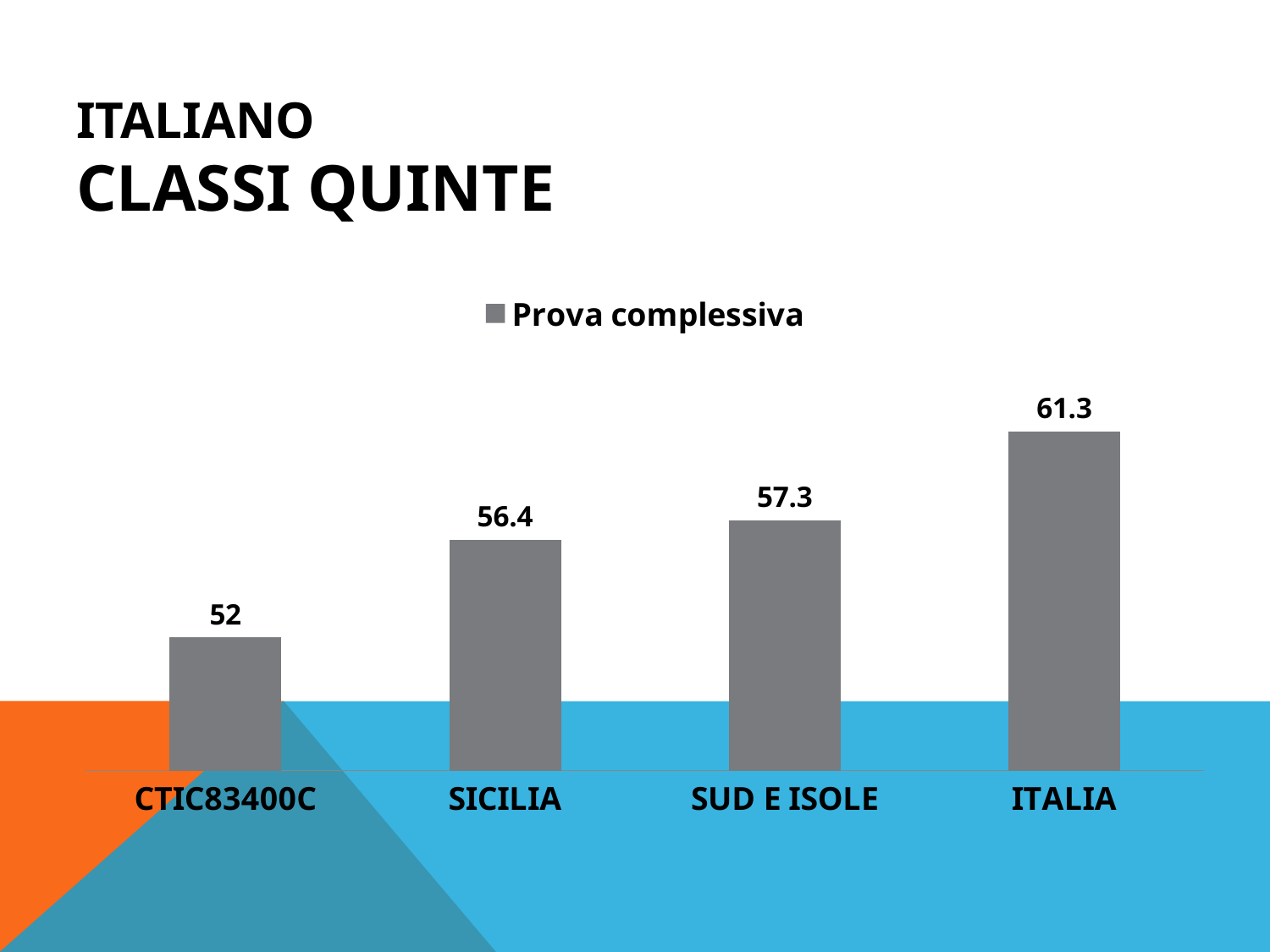
What is the value for SICILIA? 56.4 What is the value for CTIC83400C? 52 What is the value for SUD E ISOLE? 57.3 Which category has the lowest value? CTIC83400C Which category has the highest value? ITALIA What is the difference between the values for SUD E ISOLE and SICILIA? 0.9 How many categories are shown on the x axis? 4 How many series does the legend list? 1 Which is larger, the value for SICILIA or the value for ITALIA? ITALIA What kind of chart is shown on the slide? bar chart What is the value for ITALIA? 61.3 What is the difference between the values for ITALIA and CTIC83400C? 9.3